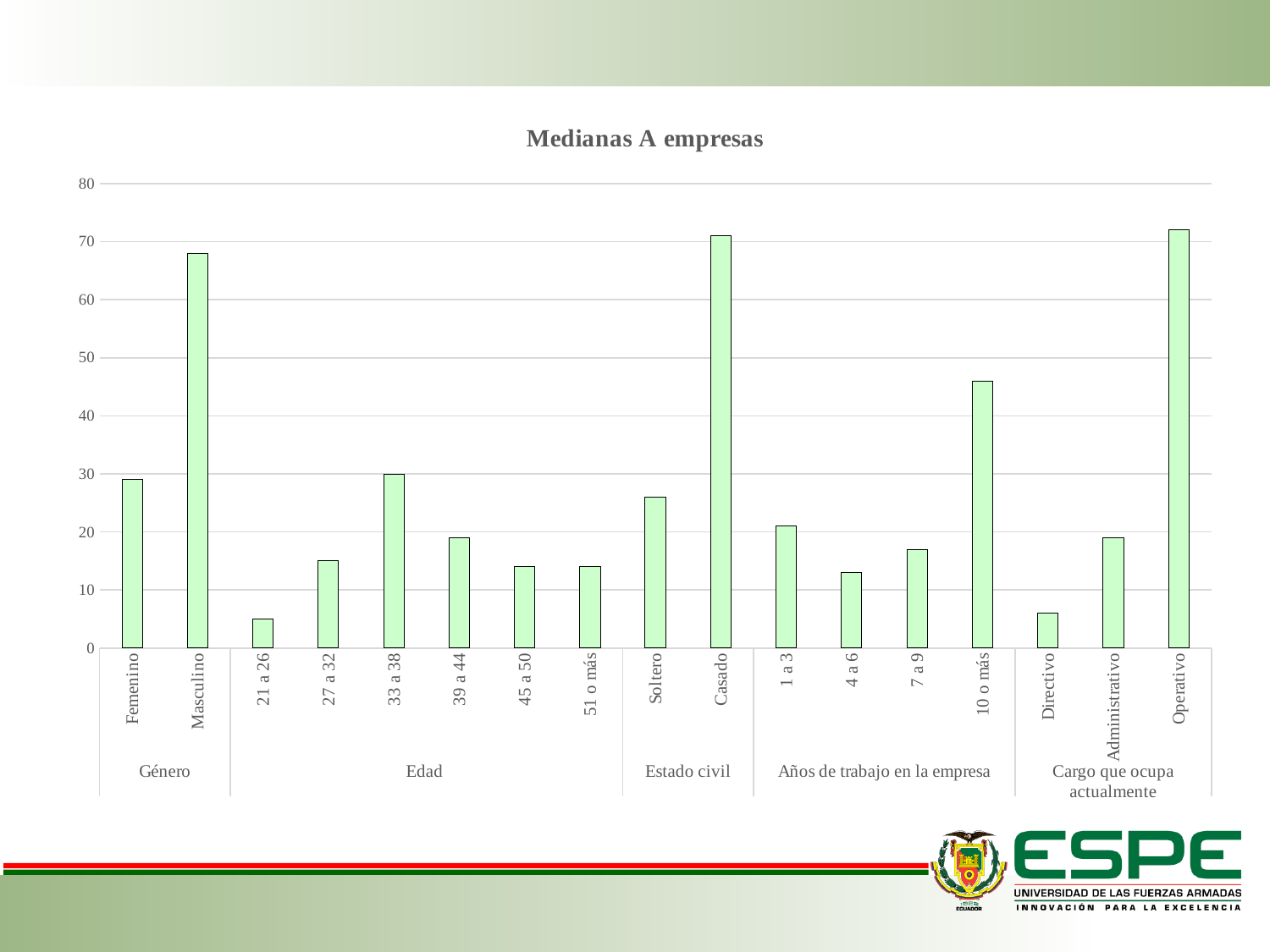
How many category groups are shown along the x axis (Género, Edad, etc.)? 5 Is the value for Masculino greater or less than 60? greater Within the Edad group, which category has the highest value? 33 a 38 Within the Edad group, which category has the lowest value? 21 a 26 Is the value for Directivo greater or less than 10? less What is the title of the chart? Medianas A empresas What kind of chart is shown on the slide? bar chart Is the value for Casado greater or less than 60? greater Which is larger, the value for Soltero or the value for Casado? Casado How many bars are plotted in the chart? 17 Within the Cargo que ocupa actualmente group, which category has the lowest value? Directivo